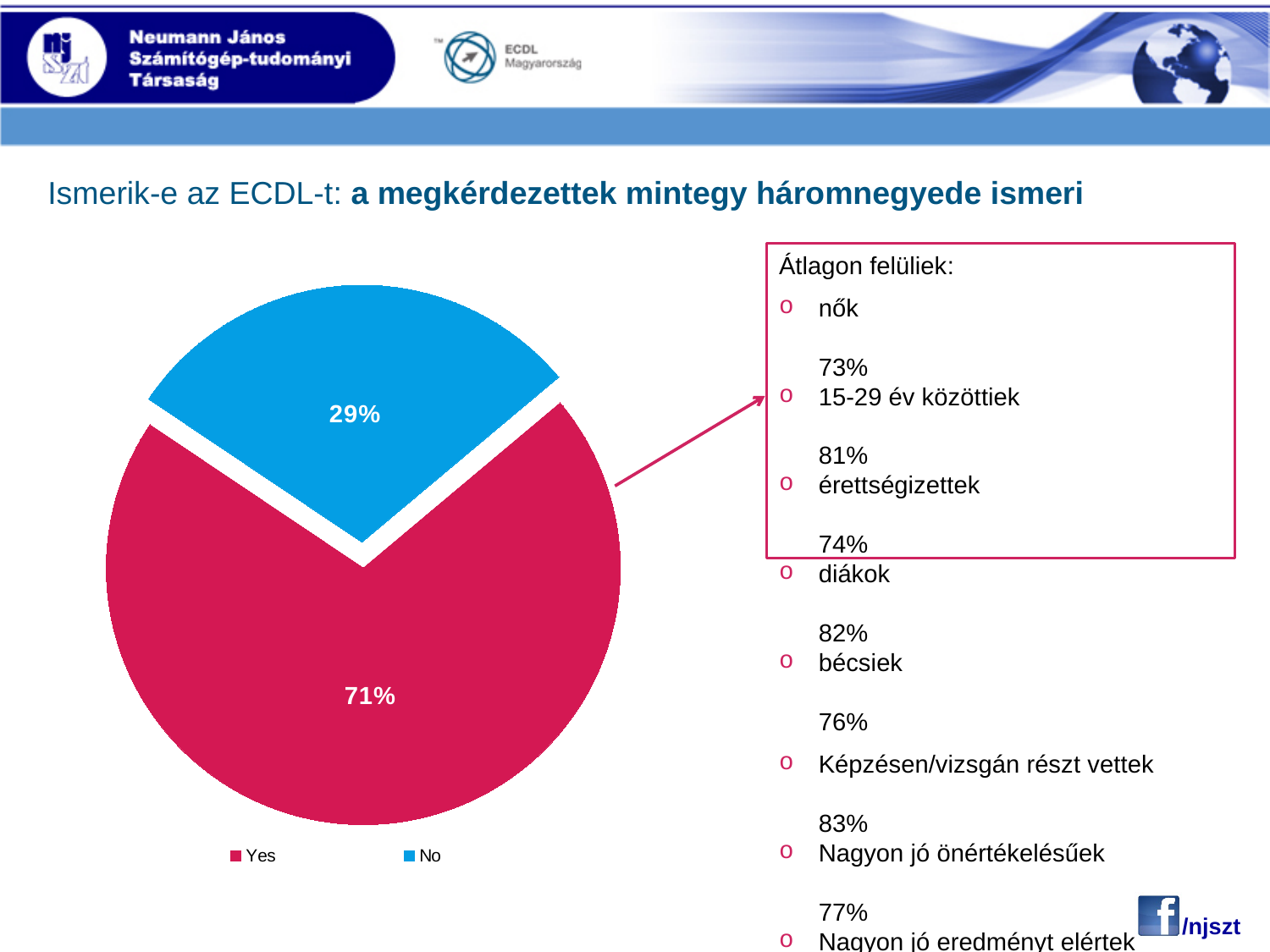
What share of the pie does the "Yes" slice represent? 71% What kind of chart is shown on the slide? pie chart Which slice of the pie is the largest? Yes Which slice of the pie is the smallest? No How many entries does the legend list? 2 What colour is the "Yes" slice of the pie? red What share of the pie does the "No" slice represent? 29% Is the value for the "No" slice greater or less than 50%? less Which is larger, the "Yes" slice or the "No" slice? Yes What colour is the "No" slice of the pie? blue How many slices does the pie chart have? 2 What is the difference in percentage points between the "Yes" and "No" slices? 42